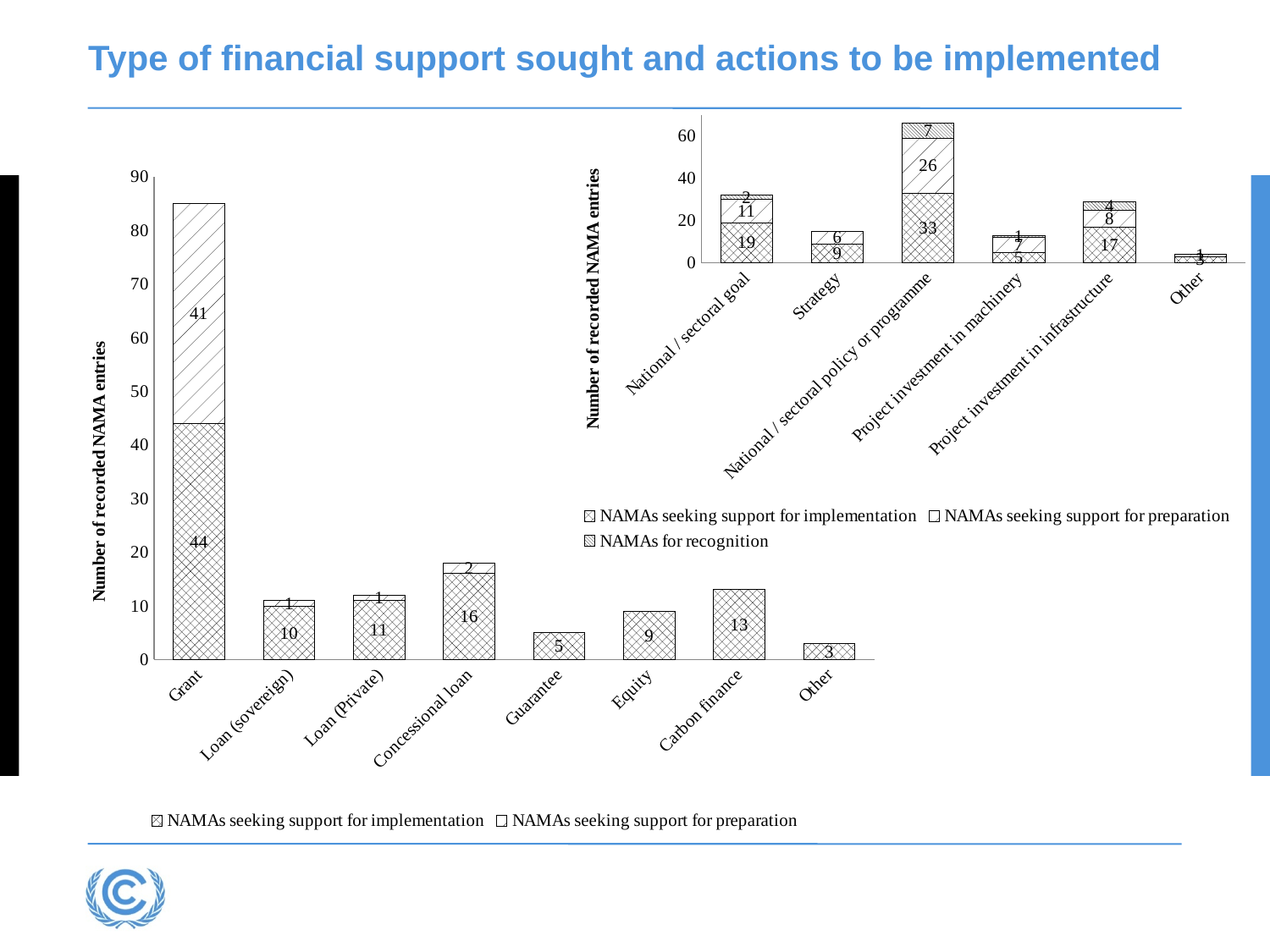
In the left chart, what is the total height of the stacked bar for Grant? 85 In the left chart, what is the difference between the implementation values for Concessional loan and Equity? 7 In the right chart, how many NAMAs seeking support for preparation are recorded for Project investment in infrastructure? 8 In the left chart, how many NAMAs seeking support for implementation are recorded for Grant? 44 In the right chart, which category has the highest total number of recorded NAMA entries? National / sectoral policy or programme In the right chart, how many series does the legend list? 3 In the left chart, which category has the highest total number of recorded NAMA entries? Grant In the left chart, how many categories are shown on the x axis? 8 In the left chart, which category has the lowest number of recorded NAMA entries? Other In the left chart, how many NAMAs seeking support for preparation are recorded for Grant? 41 In the right chart, how many NAMAs seeking support for implementation are recorded for National / sectoral policy or programme? 33 In the left chart, how many series does the legend list? 2